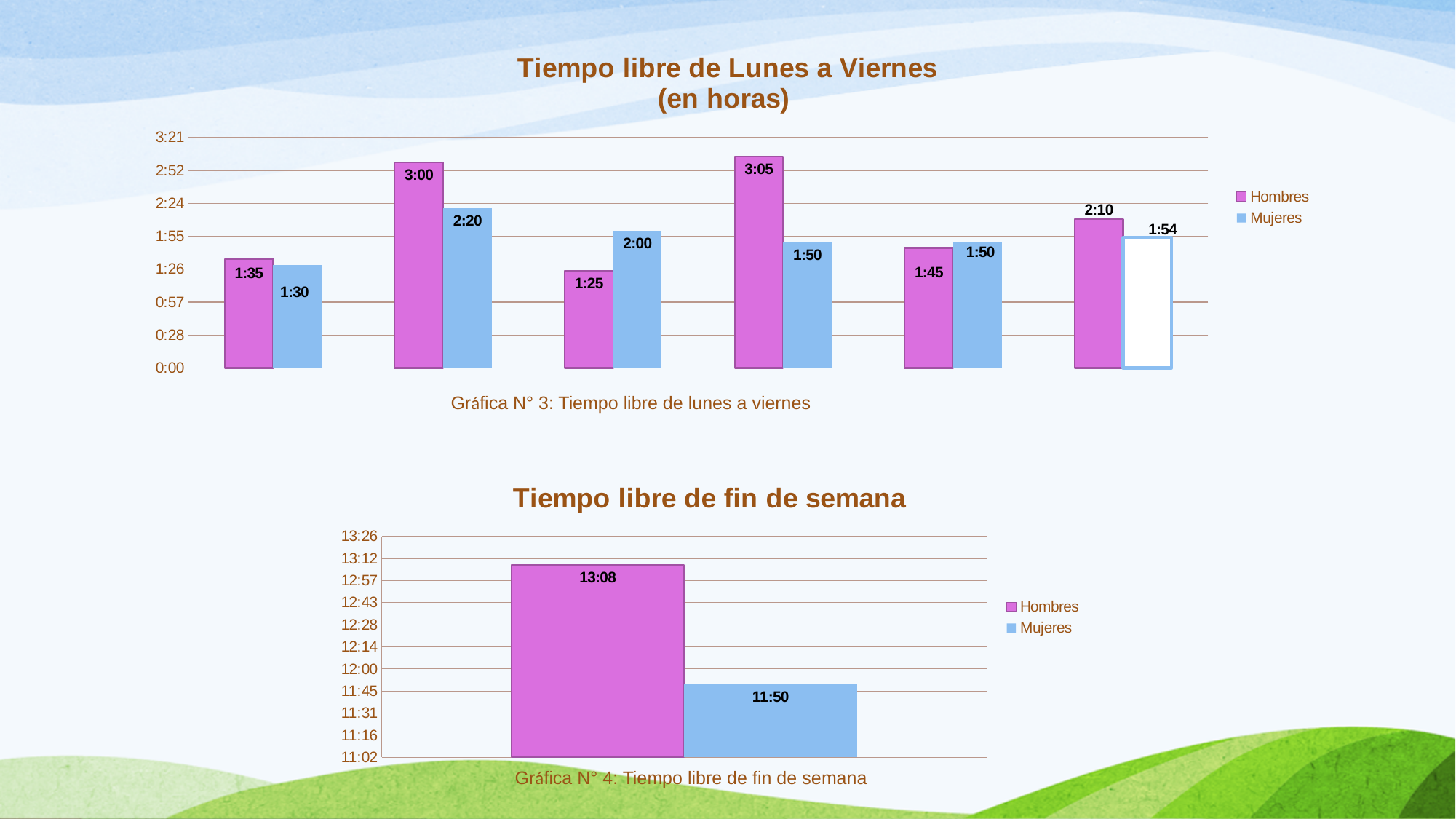
In the bottom chart 'Tiempo libre de fin de semana', which series has the larger value, Hombres or Mujeres? Hombres What kind of chart is the top chart, 'Tiempo libre de Lunes a Viernes (en horas)'? bar chart In the top chart 'Tiempo libre de Lunes a Viernes', how many groups of bars are plotted? 6 What are the two legend entries in the bottom chart 'Tiempo libre de fin de semana'? Hombres and Mujeres In the top chart 'Tiempo libre de Lunes a Viernes', in the third group of bars, which is larger, Hombres or Mujeres? Mujeres In the top chart 'Tiempo libre de Lunes a Viernes', how many series does the legend list? 2 In the bottom chart 'Tiempo libre de fin de semana', what is the value for Hombres? 13:08 In the top chart 'Tiempo libre de Lunes a Viernes', in the first group of bars, which is larger, Hombres or Mujeres? Hombres In the top chart 'Tiempo libre de Lunes a Viernes', what is the highest value shown for Hombres? 3:05 In the top chart 'Tiempo libre de Lunes a Viernes', what is the highest value shown for Mujeres? 2:20 In the top chart 'Tiempo libre de Lunes a Viernes', what is the lowest value shown for Hombres? 1:25 In the bottom chart 'Tiempo libre de fin de semana', what is the value for Mujeres? 11:50